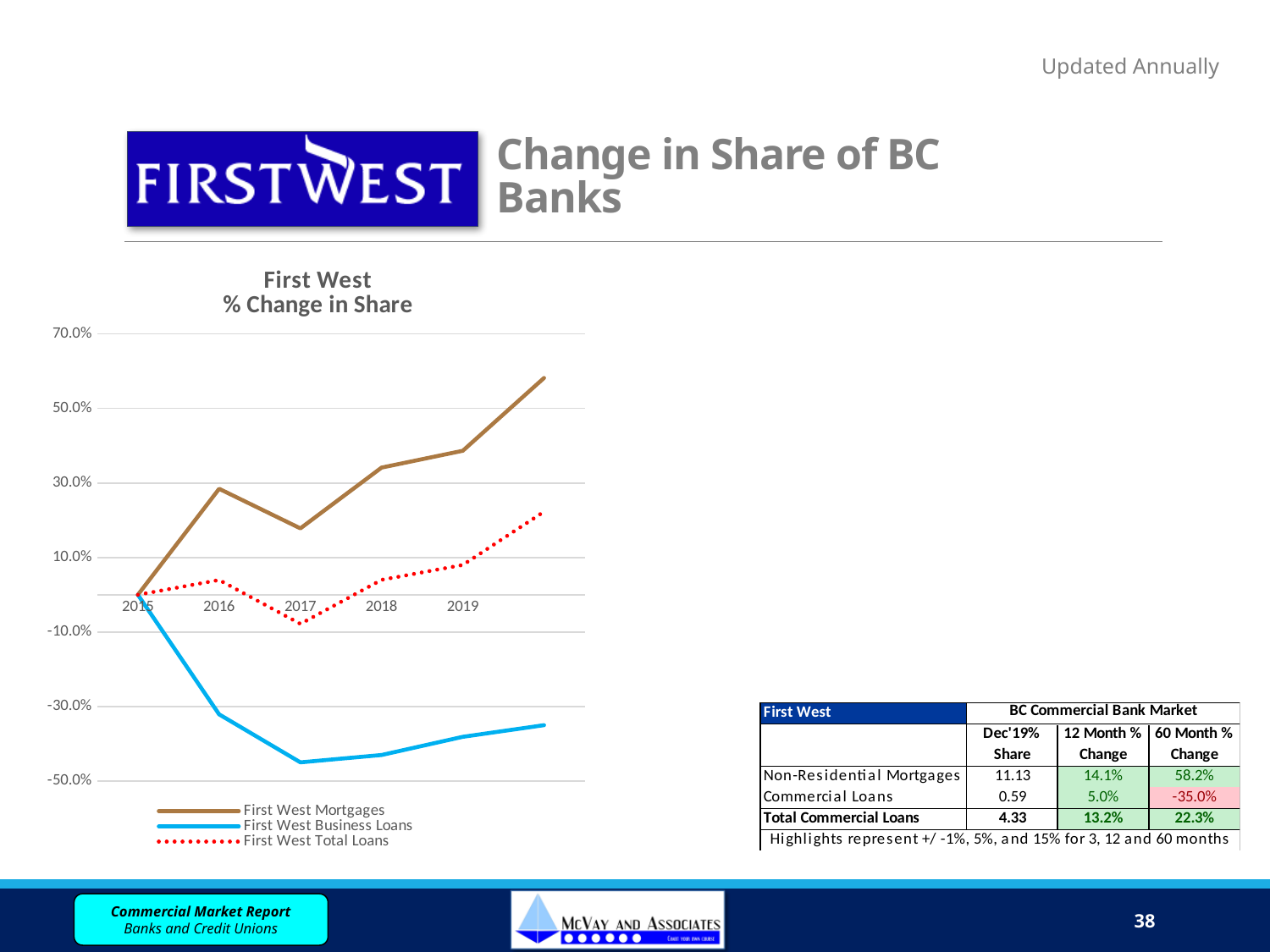
What kind of chart is the "First West % Change in Share" chart? line chart Which series has the lowest value in 2016? First West Business Loans How many series does the legend of the "First West % Change in Share" chart list? 3 Does the First West Mortgages line rise or fall from 2017 to 2019? rise Does the First West Business Loans line rise or fall from 2015 to 2017? fall Is the value for First West Business Loans in 2017 greater or less than -30.0%? less Is the value for First West Mortgages in 2016 greater or less than 10.0%? greater Which series in the chart is drawn as a red dotted line? First West Total Loans What are the three series named in the legend of the chart? First West Mortgages, First West Business Loans, First West Total Loans Is the value for First West Total Loans in 2019 greater or less than 30.0%? less In 2018, which is higher: First West Mortgages or First West Business Loans? First West Mortgages Which series has the highest value in 2019? First West Mortgages